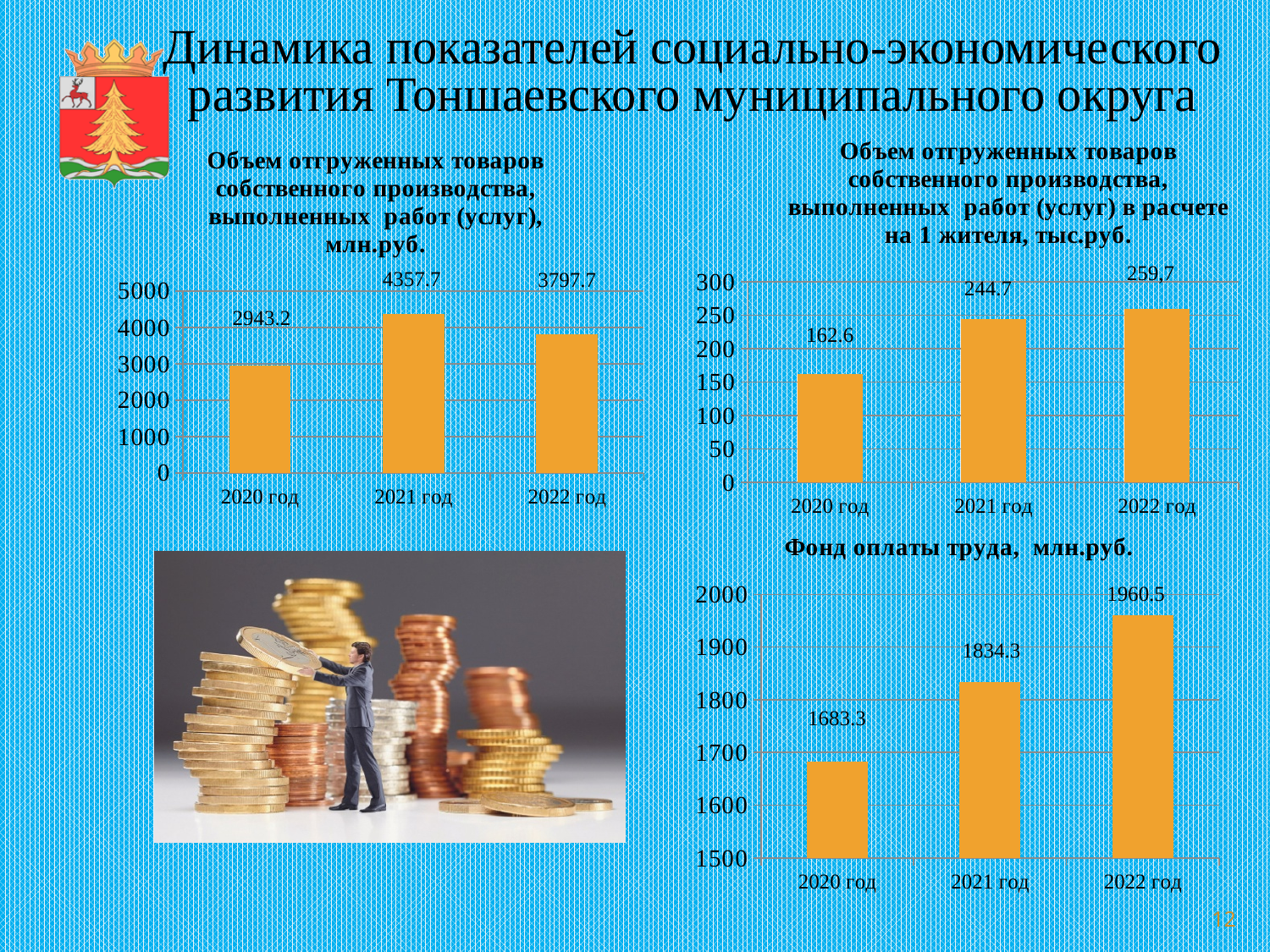
In the chart 'Фонд оплаты труда, млн.руб.', what is the value for 2022 год? 1960.5 In the top-right chart 'в расчете на 1 жителя, тыс.руб.', what is the value for 2020 год? 162.6 In the top-right chart (на 1 жителя, тыс.руб.), what is the difference between 2021 год and 2020 год? 82.1 In the top-right chart (на 1 жителя, тыс.руб.), do the values rise or fall from 2020 год to 2022 год? rise In the left chart (млн.руб.), what is the difference between the values for 2021 год and 2020 год? 1414.5 In the chart 'Объем отгруженных товаров собственного производства, выполненных работ (услуг), млн.руб.' on the left, what is the value for 2021 год? 4357.7 How many years are shown in the chart 'Фонд оплаты труда, млн.руб.'? 3 In the chart 'Фонд оплаты труда, млн.руб.', which is larger: the value for 2021 год or 2020 год? 2021 год In the left chart (млн.руб.), which year has the highest value? 2021 год In the top-right chart (на 1 жителя, тыс.руб.), what is the value for 2022 год? 259,7 In the left chart (млн.руб.), which year has the lowest value? 2020 год In the chart 'Фонд оплаты труда, млн.руб.', what is the difference between 2022 год and 2020 год? 277.2